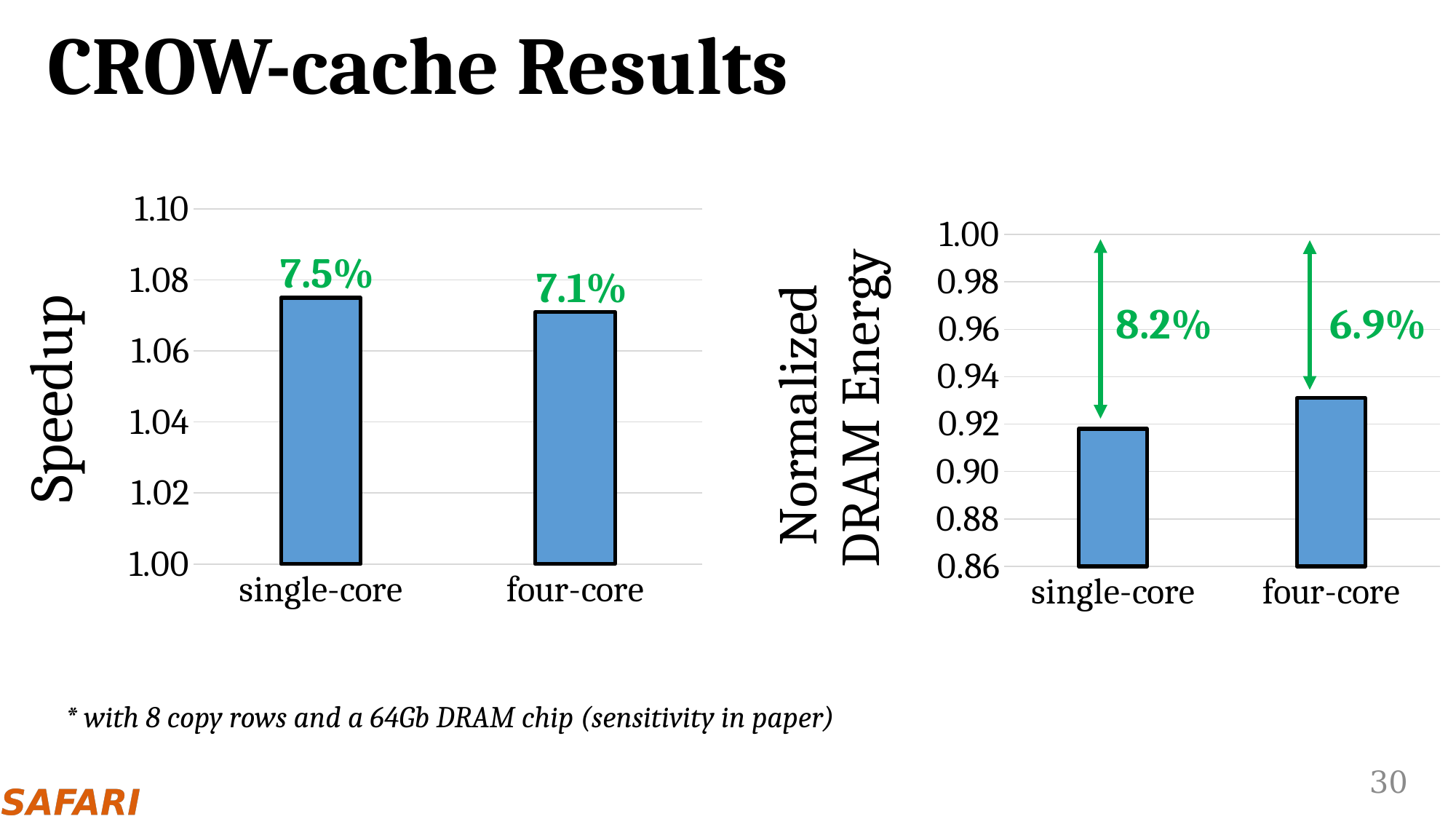
How many categories are shown on the Speedup chart? 2 On the Normalized DRAM Energy chart, what percentage is labelled next to the four-core bar? 6.9% On the Speedup chart, is the value for single-core greater or less than 1.06? greater On the Speedup chart, what percentage label is shown above the single-core bar? 7.5% What kind of chart is the Normalized DRAM Energy chart? bar chart On the Speedup chart, what is the difference between the single-core and four-core percentage labels? 0.4% On the Normalized DRAM Energy chart, what is the difference between the single-core and four-core percentage labels? 1.3% On the Speedup chart, which category has the taller bar? single-core On the Normalized DRAM Energy chart, which category has the lower bar? single-core On the Normalized DRAM Energy chart, what percentage is labelled next to the single-core bar? 8.2% On the Normalized DRAM Energy chart, is the value for four-core greater or less than 0.96? less On the Speedup chart, what percentage label is shown above the four-core bar? 7.1%